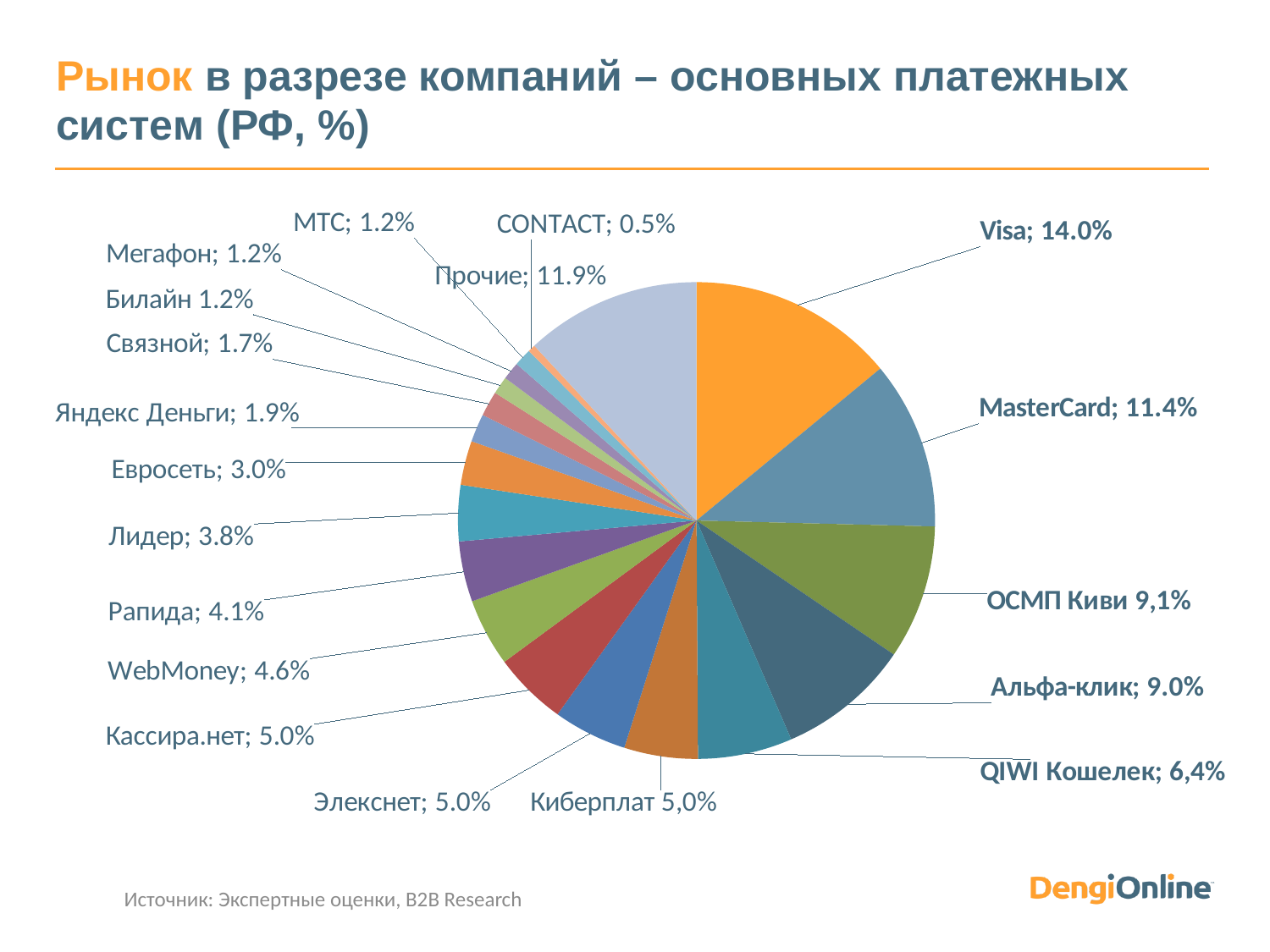
Which company has the largest slice of the pie? Visa What is the value shown for MasterCard? 11.4% What is the difference between the shares of Visa and MasterCard? 2.6% What share of the market does Visa hold? 14.0% What kind of chart is shown on the slide? Pie chart Which is larger, the share of Рапида or the share of Лидер? Рапида Which company has the smallest slice of the pie? CONTACT What is the value shown for Яндекс Деньги? 1.9% How many slices does the pie chart have? 19 What is the value shown for Прочие? 11.9% What source is cited at the bottom of the slide? Экспертные оценки, B2B Research What is the value shown for WebMoney? 4.6%